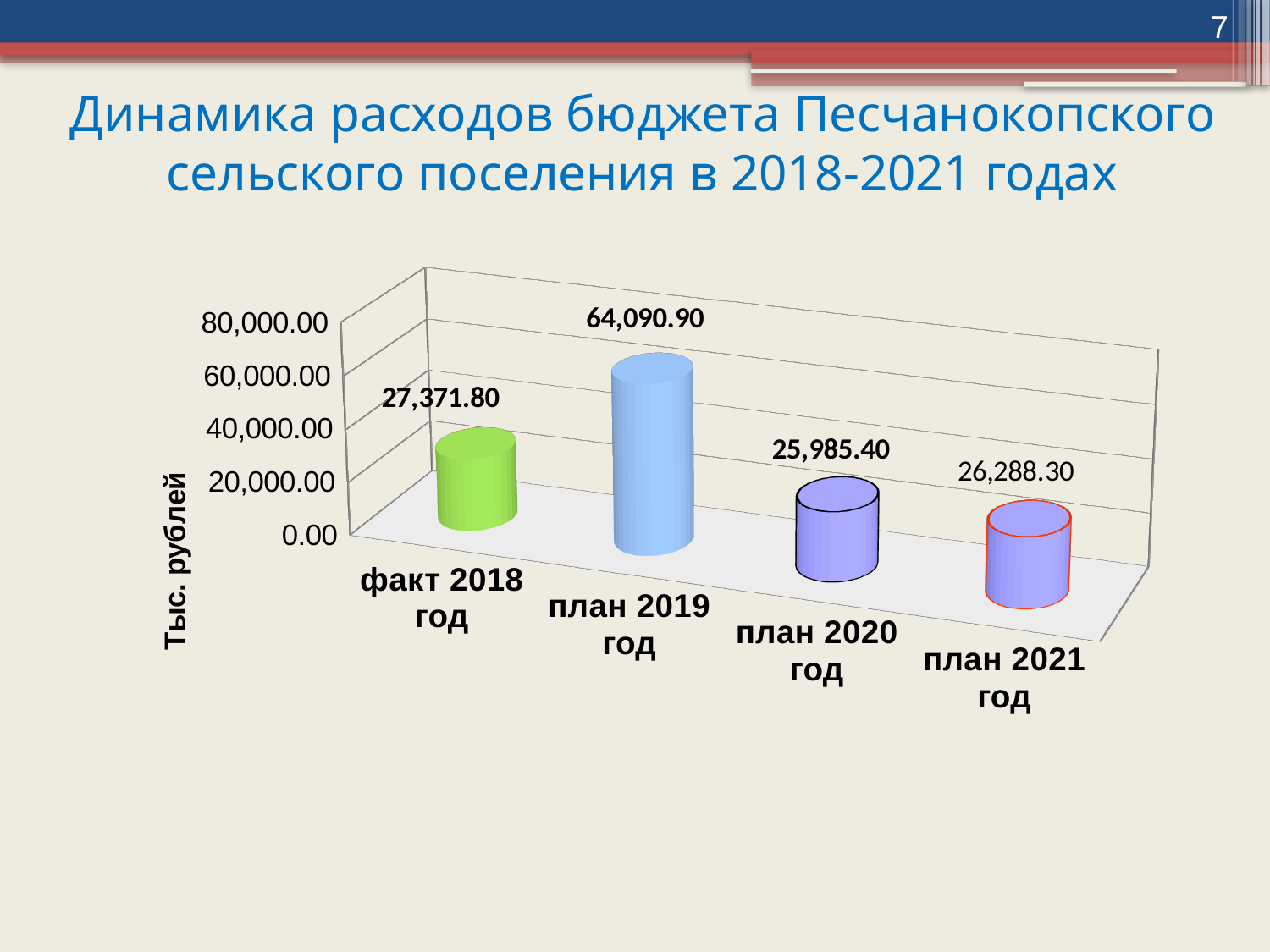
Which category has the highest value? план 2019 год Which is larger, the value for план 2019 год or the value for план 2020 год? план 2019 год What is the value for план 2021 год? 26,288.30 What is the value for факт 2018 год? 27,371.80 Which category has the lowest value? план 2020 год What is the label of the vertical axis? Тыс. рублей What is the value for план 2019 год? 64,090.90 What is the difference between the values for план 2019 год and факт 2018 год? 36,719.10 How many categories are shown on the chart? 4 Is the value for план 2019 год greater or less than 60,000.00? greater What is the value for план 2020 год? 25,985.40 What is the difference between the values for план 2021 год and план 2020 год? 302.90